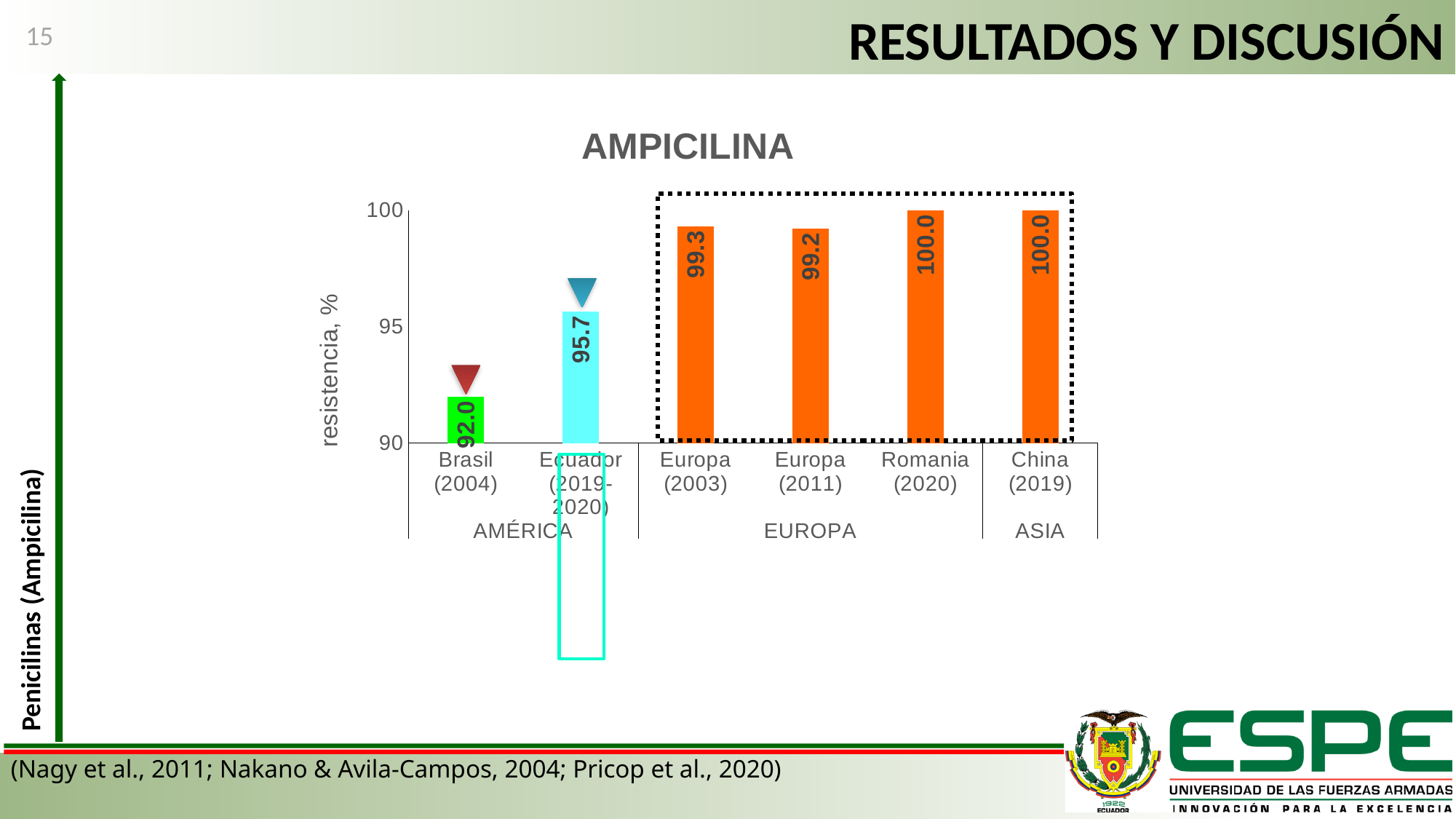
What kind of chart is shown on the slide? bar chart What is the resistance value for Europa (2011)? 99.2 What is the resistance value for Brasil (2004)? 92.0 How many bars are plotted in the chart? 6 Which category has the lowest resistance value? Brasil (2004) Which is larger, the resistance value for Europa (2003) or for Ecuador (2019-2020)? Europa (2003) What is the difference between the resistance values for Ecuador (2019-2020) and Brasil (2004)? 3.7 Is the value for Brasil (2004) greater or less than 95? less What is the title of the chart? AMPICILINA What is the resistance value for Europa (2003)? 99.3 What is the difference between the resistance values for Romania (2020) and Europa (2003)? 0.7 What is the resistance value for Ecuador (2019-2020)? 95.7